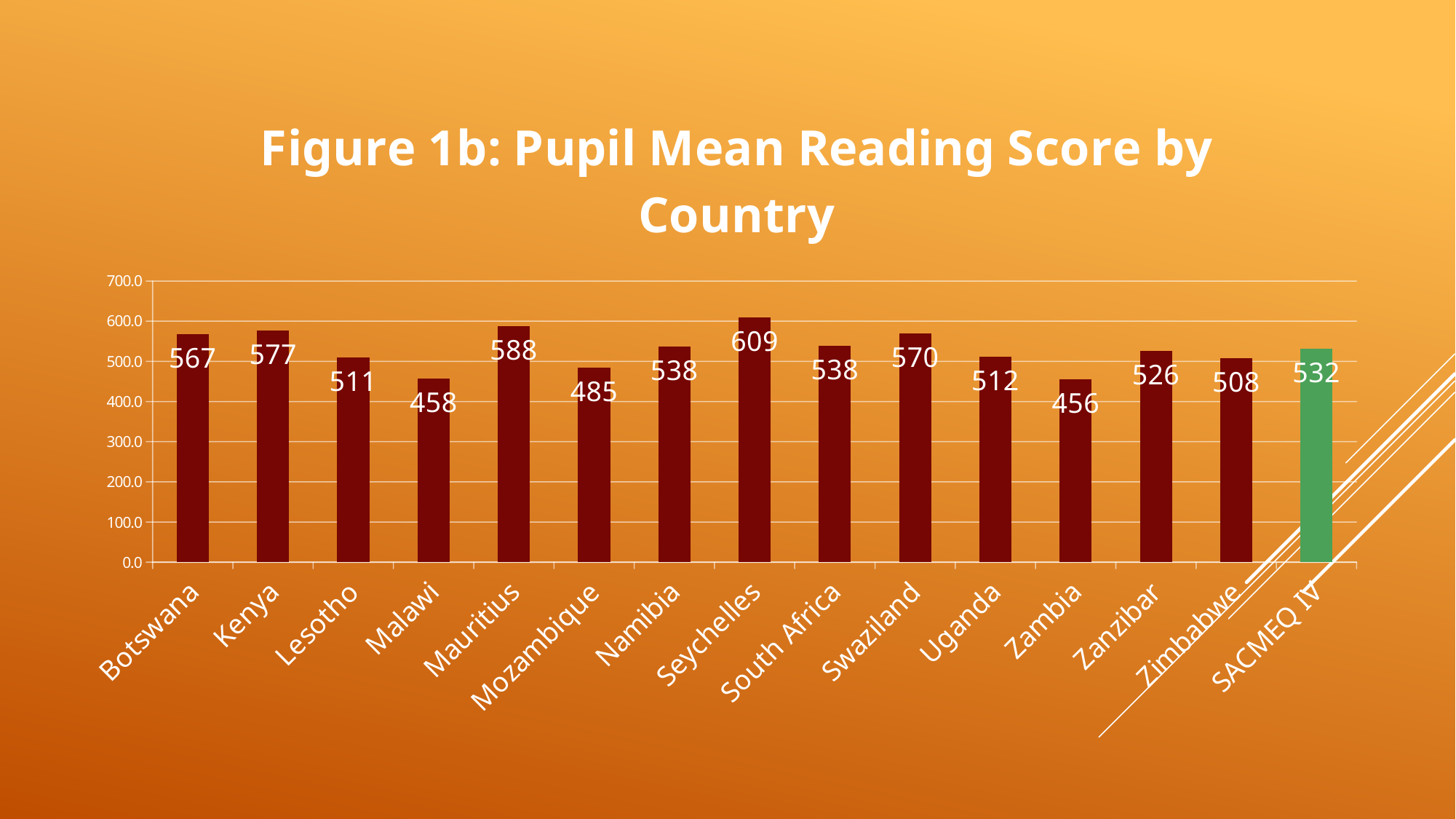
How many categories are shown on the x axis? 15 What is the pupil mean reading score for Seychelles? 609 What is the title of the chart? Figure 1b: Pupil Mean Reading Score by Country Which country has the lowest pupil mean reading score? Zambia Which has a higher pupil mean reading score, Mauritius or Swaziland? Mauritius Which country has the highest pupil mean reading score? Seychelles What is the pupil mean reading score for Malawi? 458 What is the value shown for SACMEQ IV? 532 What kind of chart is shown on the slide? bar chart What is the difference between the reading scores of Seychelles and Zambia? 153 What is the difference between the reading scores of Kenya and Botswana? 10 Is the value for Mozambique greater or less than 500? less